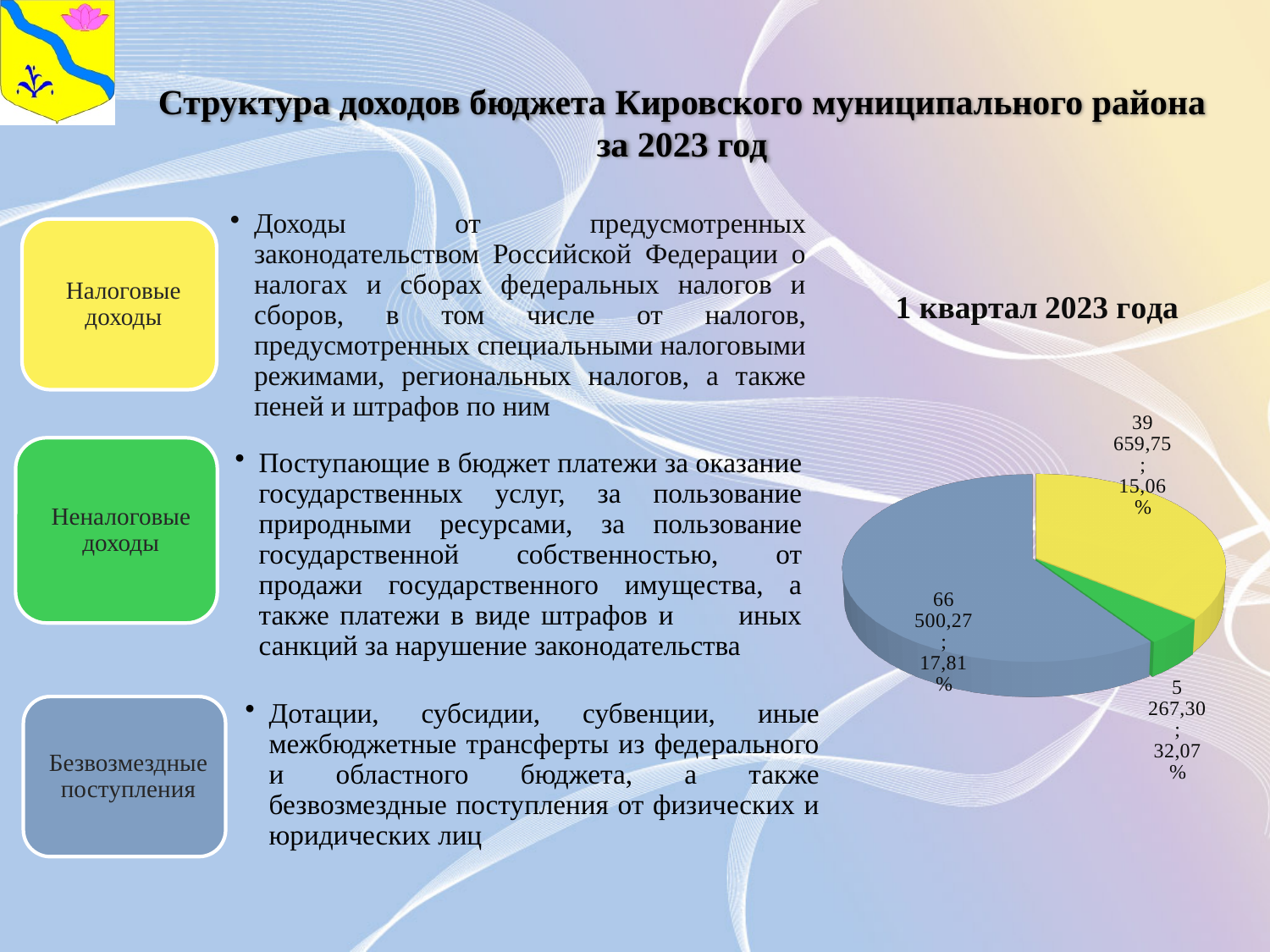
Which has the larger value, the yellow slice or the green slice? the yellow slice What is the difference between the value on the blue slice and the value on the yellow slice? 26 840,52 What is the title of the pie chart? 1 квартал 2023 года Which slice of the pie chart has the largest value? the blue slice (66 500,27) What percentage is printed on the blue slice of the pie chart? 17,81% Which slice of the pie chart has the smallest value? the green slice (5 267,30) How many slices does the pie chart have? 3 What value is printed on the blue slice of the pie chart? 66 500,27 What kind of chart is shown on the slide? pie chart What percentage is printed on the green slice of the pie chart? 32,07% What colour is the largest slice of the pie chart? blue What value is printed on the yellow slice of the pie chart? 39 659,75